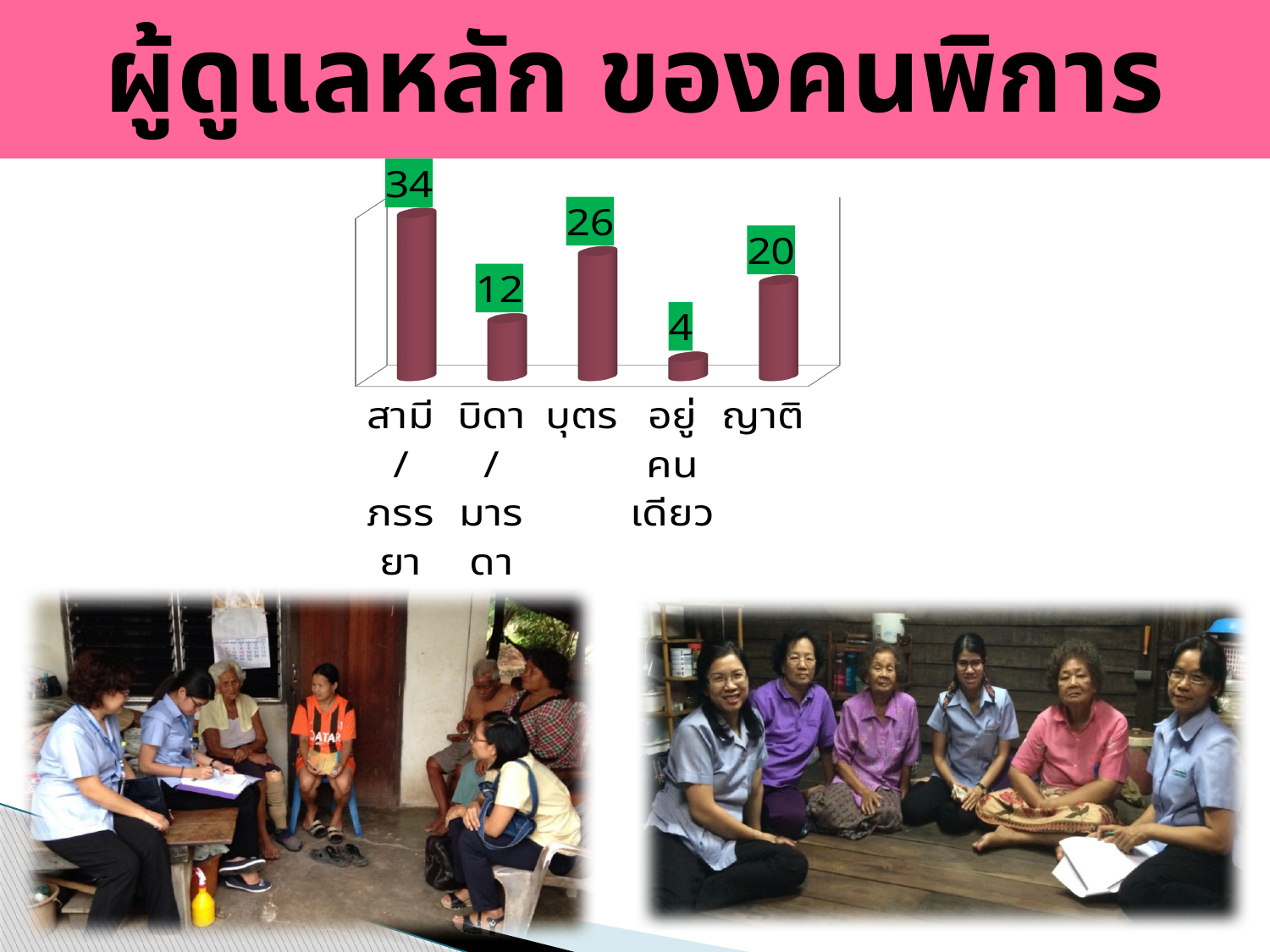
Which category has the highest value? สามี/ภรรยา What is the title of the slide? ผู้ดูแลหลัก ของคนพิการ What is the value for อยู่คนเดียว? 4 What kind of chart is shown on the slide? bar chart What is the value for ญาติ? 20 What is the value for บิดา/มารดา? 12 What is the difference between the values for สามี/ภรรยา and บุตร? 8 What is the value for สามี/ภรรยา? 34 Which category has the lowest value? อยู่คนเดียว How many categories are shown in the chart? 5 Which is larger, the value for ญาติ or the value for บิดา/มารดา? ญาติ What is the value for บุตร? 26